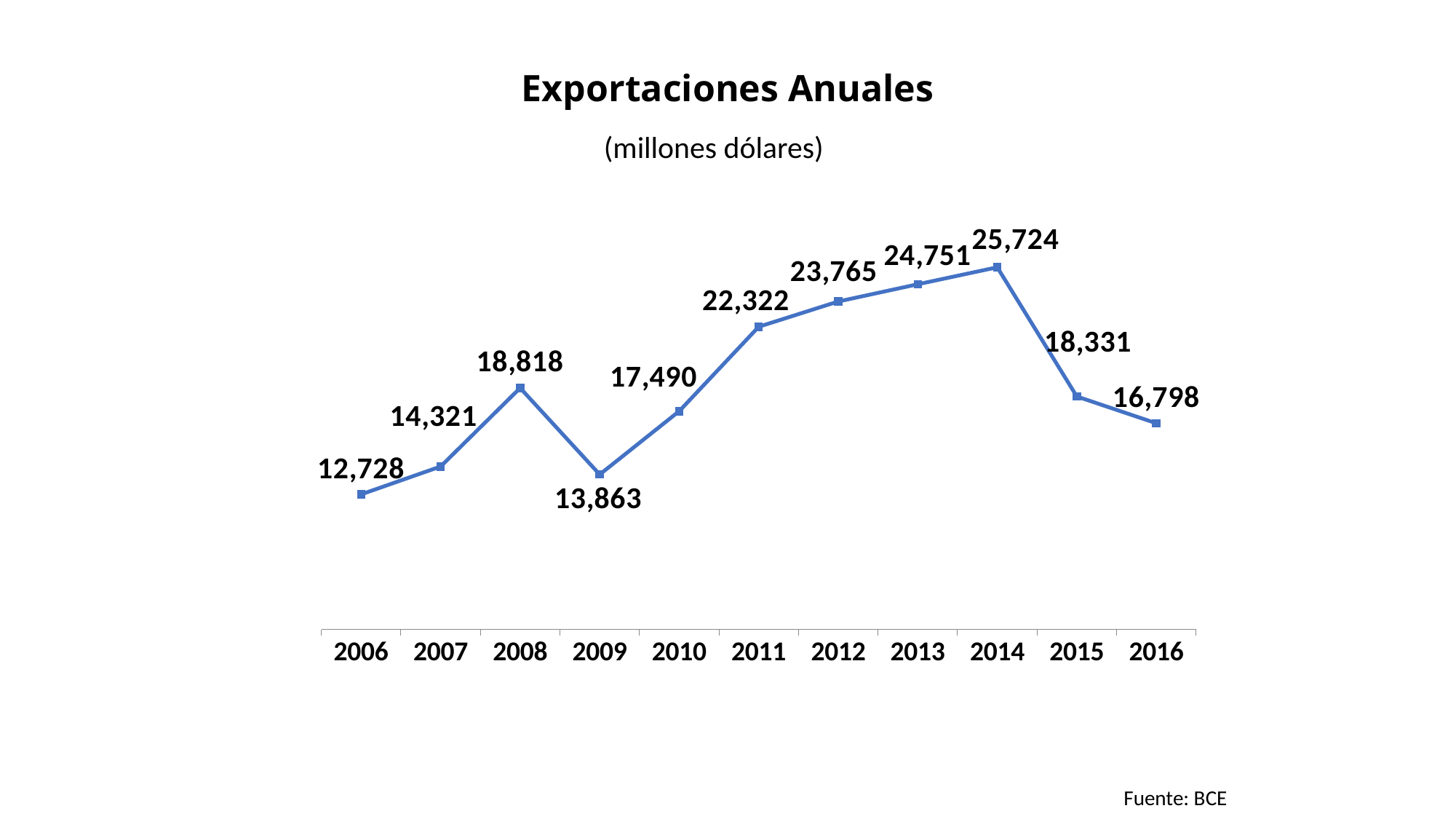
What is the difference between the values for 2014 and 2015? 7,393 What is the value for 2016? 16,798 How many years are plotted on the x axis? 11 What is the value for 2008? 18,818 Do the values rise or fall from 2009 to 2014? rise What is the value for 2012? 23,765 Which year has the highest value? 2014 Which year has the lowest value? 2006 What is the title of the chart? Exportaciones Anuales What is the difference between the values for 2008 and 2009? 4,955 Which is larger, the value for 2010 or the value for 2015? 2015 What type of chart is shown on the slide? line chart